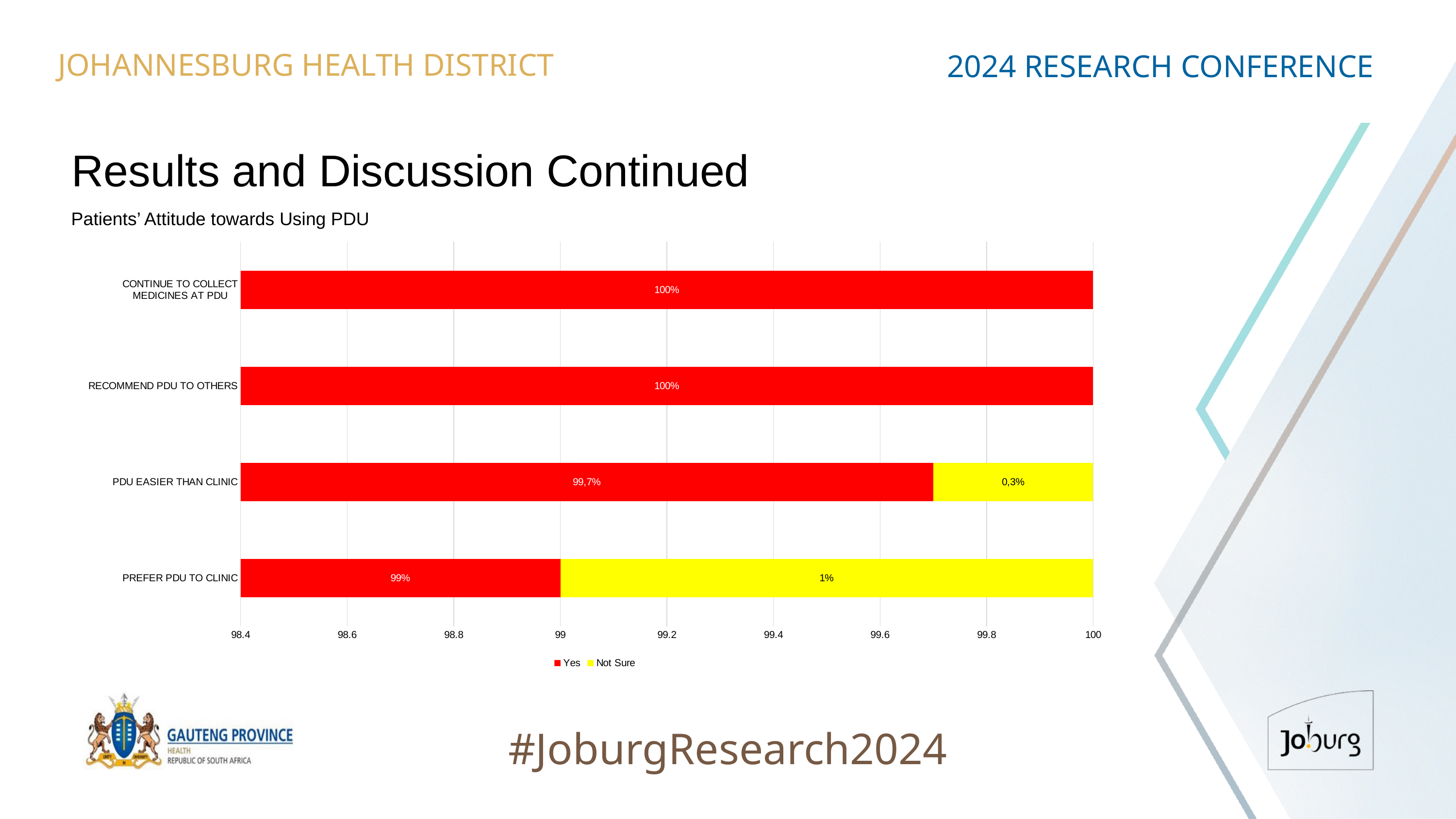
Is the Yes value for "PDU easier than clinic" larger or smaller than the Yes value for "Prefer PDU to clinic"? larger How many categories are shown on the chart? 4 What is the Not Sure value for "Prefer PDU to clinic"? 1% Which category has the lowest Yes value? Prefer PDU to clinic What is the Yes value for "PDU easier than clinic"? 99,7% What percentage of patients said Yes to "Prefer PDU to clinic"? 99% Which category has the largest Not Sure share? Prefer PDU to clinic What is the Not Sure value for "PDU easier than clinic"? 0,3% What is the Yes value for "Recommend PDU to others"? 100% What kind of chart is shown on the slide? stacked bar chart Which colour represents the Not Sure series? yellow How many series does the legend list? 2